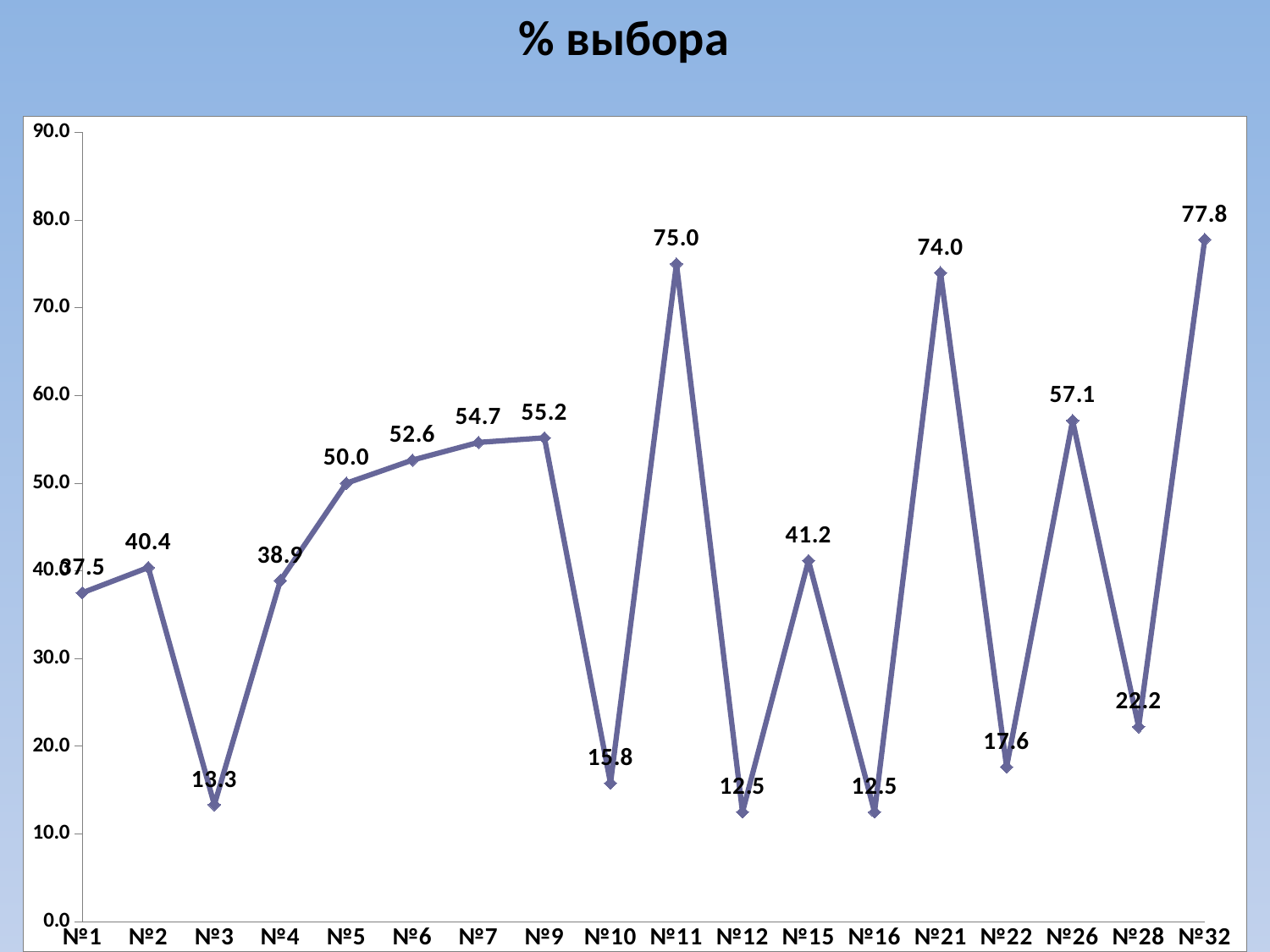
What kind of chart is shown on the slide? line chart What is the title of the chart? % выбора What is the difference between the values for №32 and №11? 2.8 Do the values rise or fall from №4 to №9? rise Is the value for №10 greater or less than 20.0? less What is the value for №26? 57.1 What is the difference between the values for №21 and №22? 56.4 How many categories are plotted along the x axis? 18 What is the value for №3? 13.3 Which is larger, the value for №15 or the value for №28? №15 Which category has the highest value? №32 What is the value for №11? 75.0